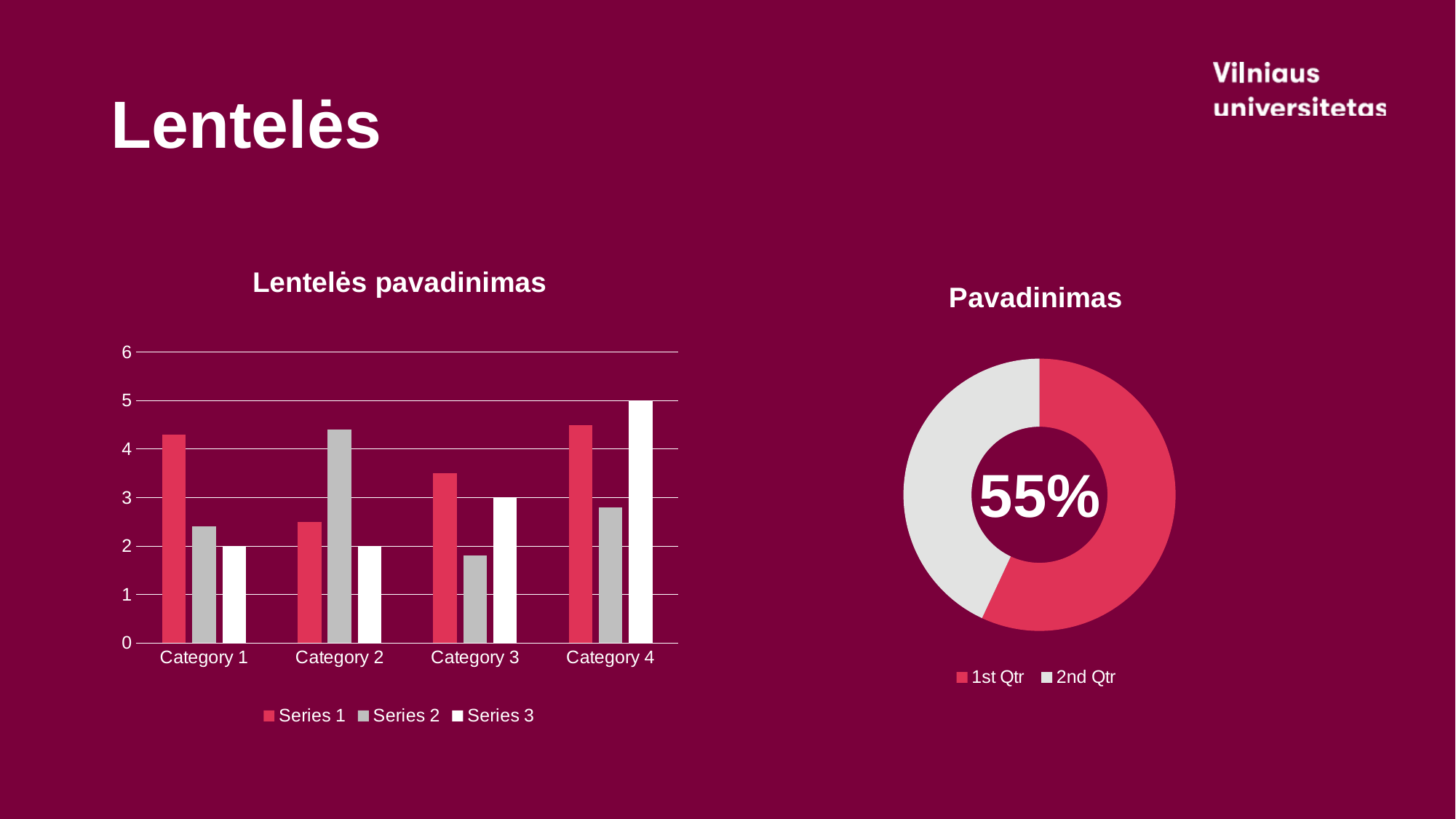
In the chart titled "Lentelės pavadinimas", which category has the highest Series 3 value? Category 4 In the chart titled "Lentelės pavadinimas", how many series does the legend list? 3 In the chart titled "Lentelės pavadinimas", what is the value of Series 3 for Category 4? 5 In the chart titled "Pavadinimas", how many entries does the legend list? 2 In the chart titled "Lentelės pavadinimas", is the value of Series 1 for Category 1 greater or less than 4? greater In the chart titled "Pavadinimas", what percentage is printed in the centre of the donut? 55% In the chart titled "Lentelės pavadinimas", what is the value of Series 3 for Category 3? 3 In the chart titled "Lentelės pavadinimas", which is larger for Category 2: Series 1 or Series 2? Series 2 What kind of chart is the chart titled "Pavadinimas"? donut (pie) chart In the chart titled "Lentelės pavadinimas", how many categories are shown on the x axis? 4 What kind of chart is the chart titled "Lentelės pavadinimas"? bar chart In the chart titled "Lentelės pavadinimas", is the value of Series 2 for Category 3 greater or less than 2? less